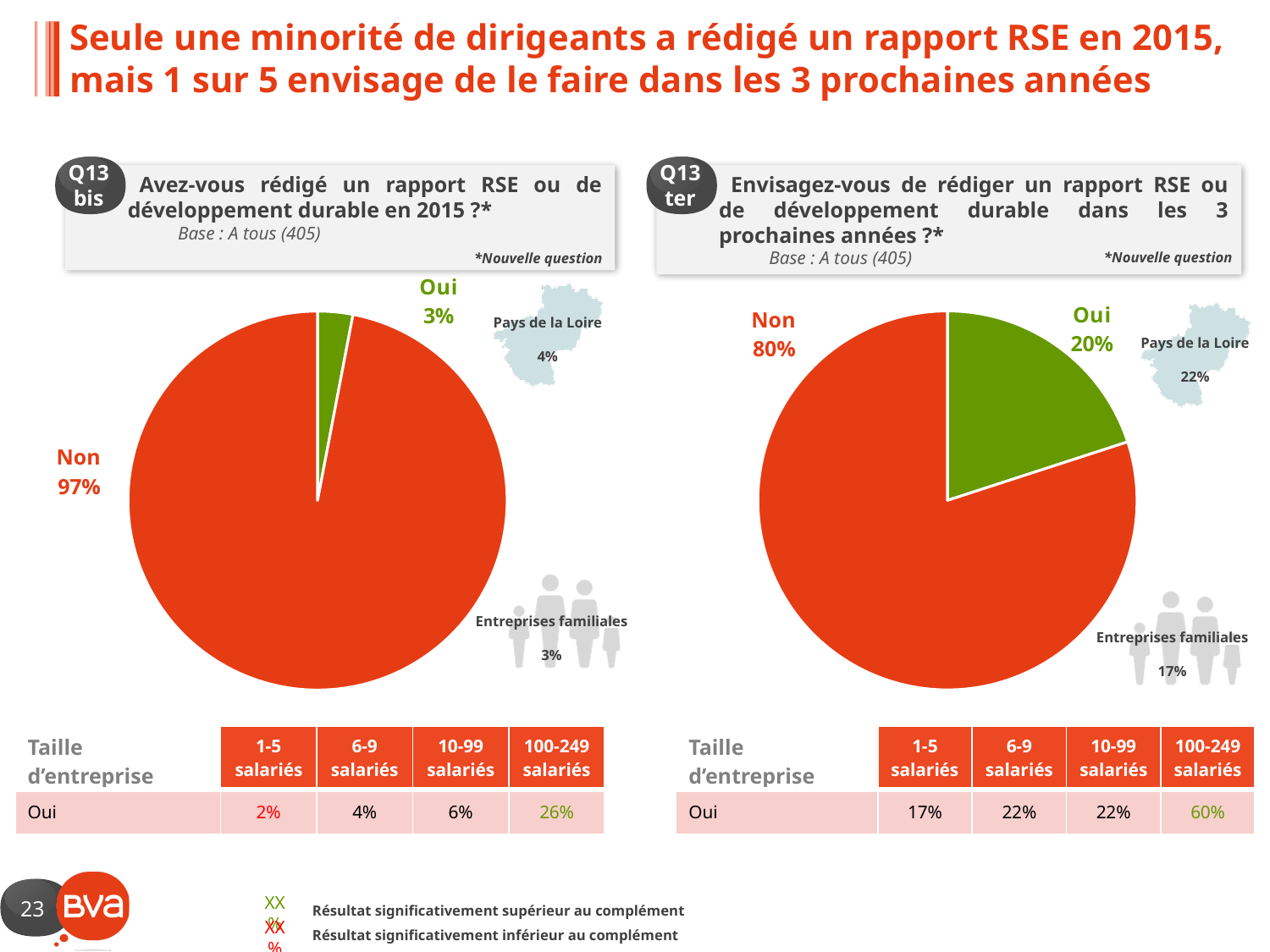
In the right pie chart (Q13 ter), what share of respondents answered "Non"? 80% In the left pie chart (Q13 bis), what share of respondents answered "Non"? 97% How many slices does the right pie chart (Q13 ter) have? 2 What colour is the "Oui" slice in the left pie chart (Q13 bis)? Green In the left pie chart (Q13 bis), what share of respondents answered "Oui"? 3% What kind of chart is used on the left (Q13 bis) to show whether leaders wrote a CSR report in 2015? Pie chart In the left pie chart (Q13 bis), which answer has the largest slice? Non In the right pie chart (Q13 ter), what share of respondents answered "Oui"? 20% Which is larger: the "Oui" share in the left pie chart (Q13 bis) or the "Oui" share in the right pie chart (Q13 ter)? Right pie chart (Q13 ter) What is the difference between the "Non" and "Oui" shares in the right pie chart (Q13 ter)? 60 percentage points In the right pie chart (Q13 ter), which answer has the smallest slice? Oui What is the difference between the "Non" and "Oui" shares in the left pie chart (Q13 bis)? 94 percentage points